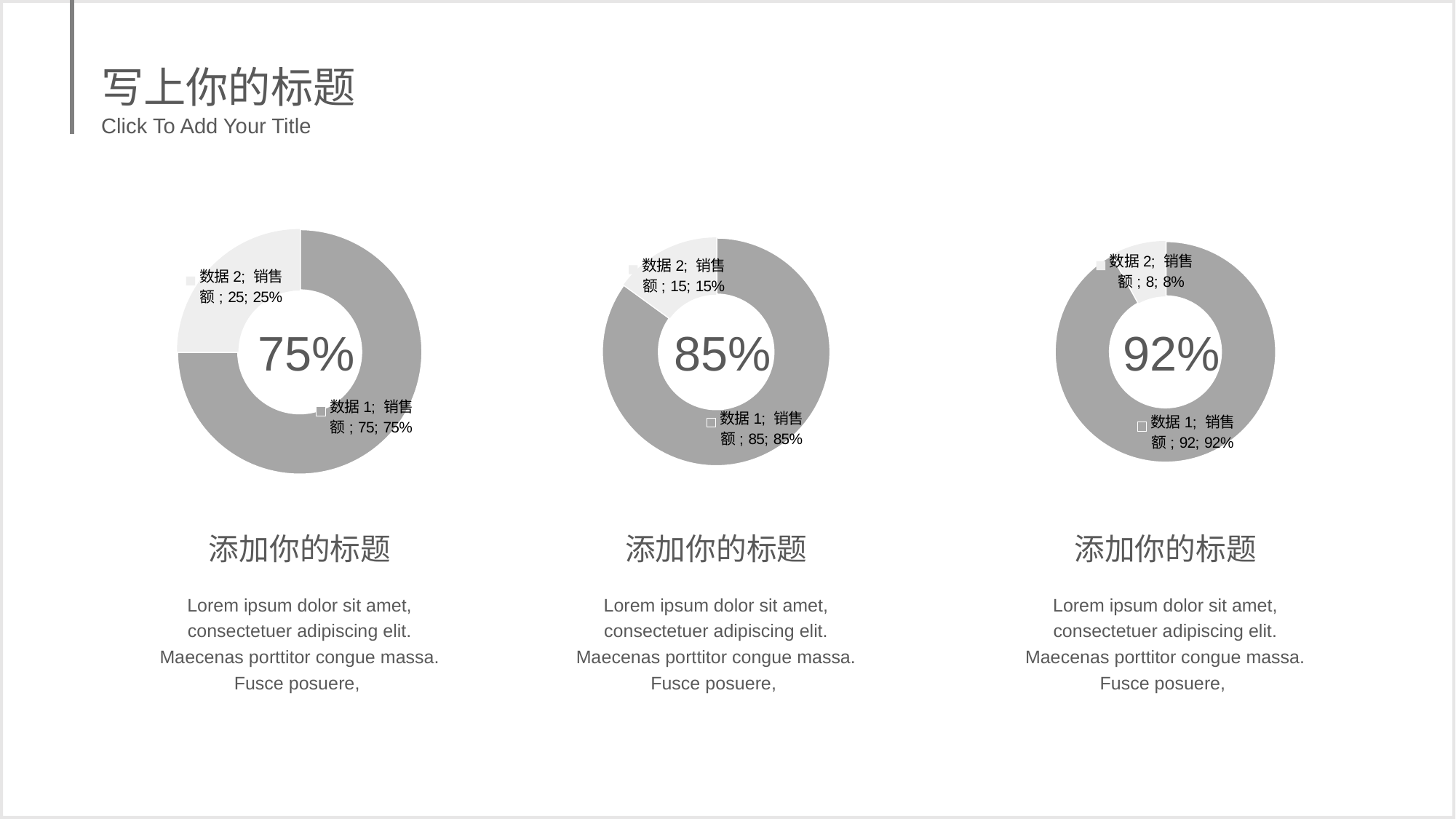
In the right chart, which category is the largest? 数据 1 In the left chart, what share of the doughnut does 数据 2 take? 25% In the middle chart, what is the value for 数据 2? 15 How many slices does the right chart have? 2 In the middle chart, what share of the doughnut does 数据 1 take? 85% What kind of chart is the left chart on the slide? Doughnut chart In the right chart, what share of the doughnut does 数据 2 take? 8% In the left chart, what is the difference between the values for 数据 1 and 数据 2? 50 In the left chart, what is the value for 数据 1? 75 What percentage is printed in the centre of the middle chart? 85% In the middle chart, which category is the smallest? 数据 2 In the right chart, what is the value for 数据 1? 92